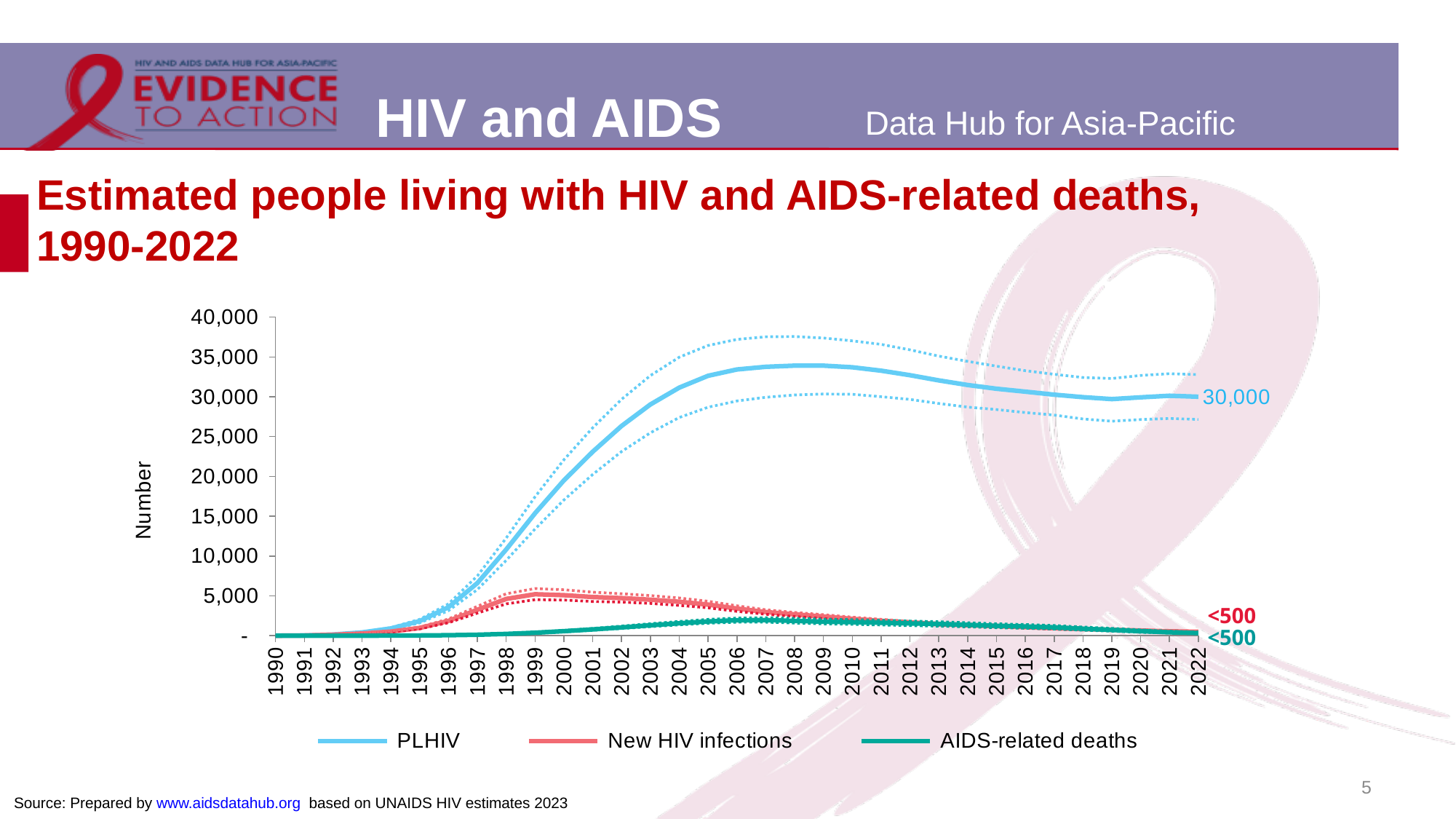
How many series does the legend list? 3 What is the value of PLHIV in 2022? 30,000 Does the PLHIV line rise or fall from 1990 to 2008? Rise Does the PLHIV line rise or fall from 2009 to 2019? Fall Is the value for PLHIV in 2000 greater or less than 25,000? less What is the label on the vertical axis? Number What is the value of AIDS-related deaths in 2022? <500 How many years are shown on the x axis? 33 What is the value of New HIV infections in 2022? <500 Which series has the highest value in 2022? PLHIV What kind of chart is shown on the slide? Line chart Is the value for PLHIV in 2008 greater or less than 30,000? greater